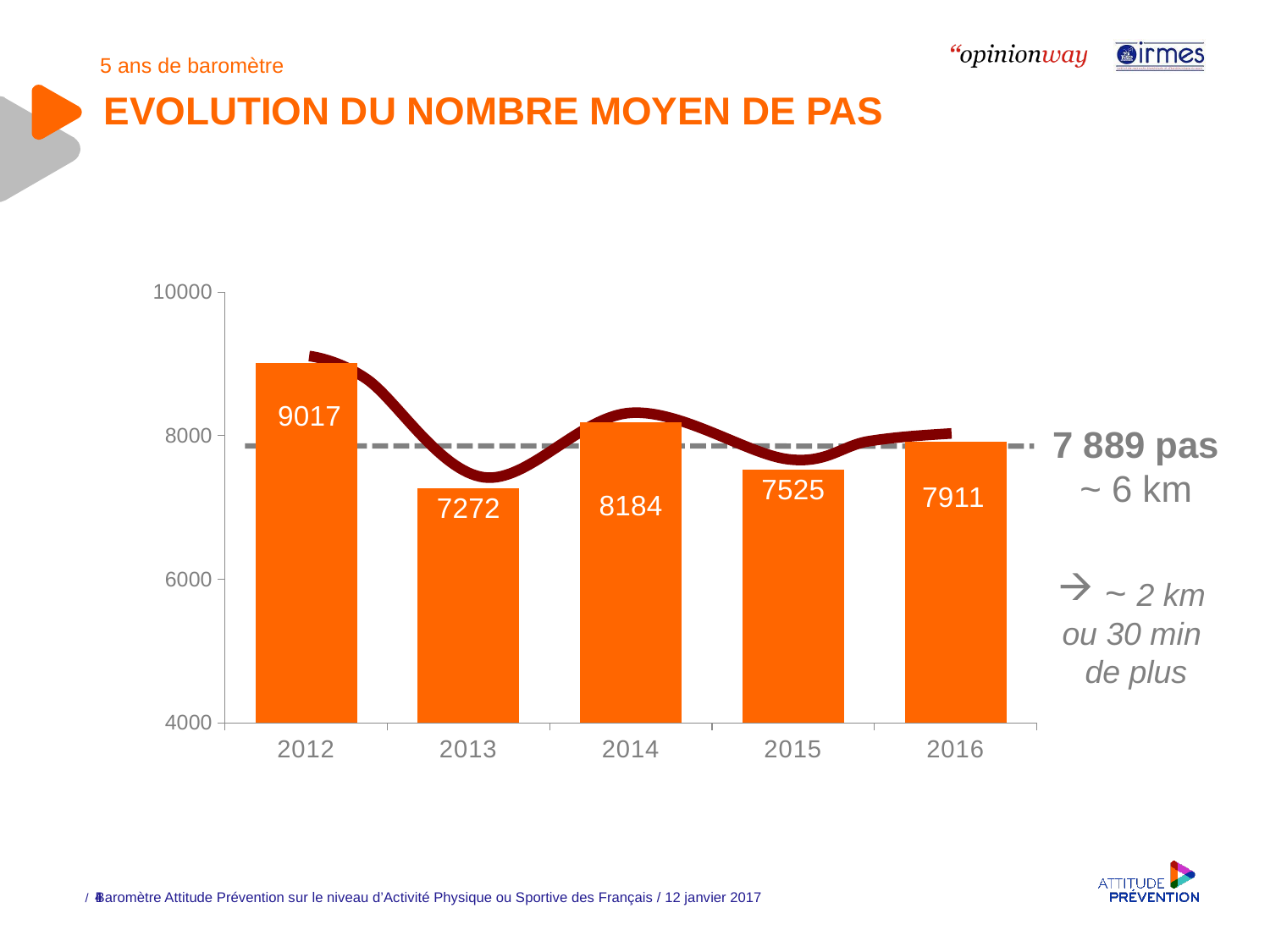
What kind of chart is shown on the slide? bar chart How many years are shown on the x axis? 5 What is the value shown for 2016? 7911 What is the difference between the values for 2012 and 2013? 1745 What is the average number of steps shown for 2012? 9017 Which is larger, the value for 2014 or the value for 2016? 2014 What is the difference between the values for 2014 and 2015? 659 Is the value for 2015 greater or less than 8000? less Which year has the lowest average number of steps? 2013 What is the value shown for 2013? 7272 Which year has the highest average number of steps? 2012 What is the title of the chart on the slide? EVOLUTION DU NOMBRE MOYEN DE PAS